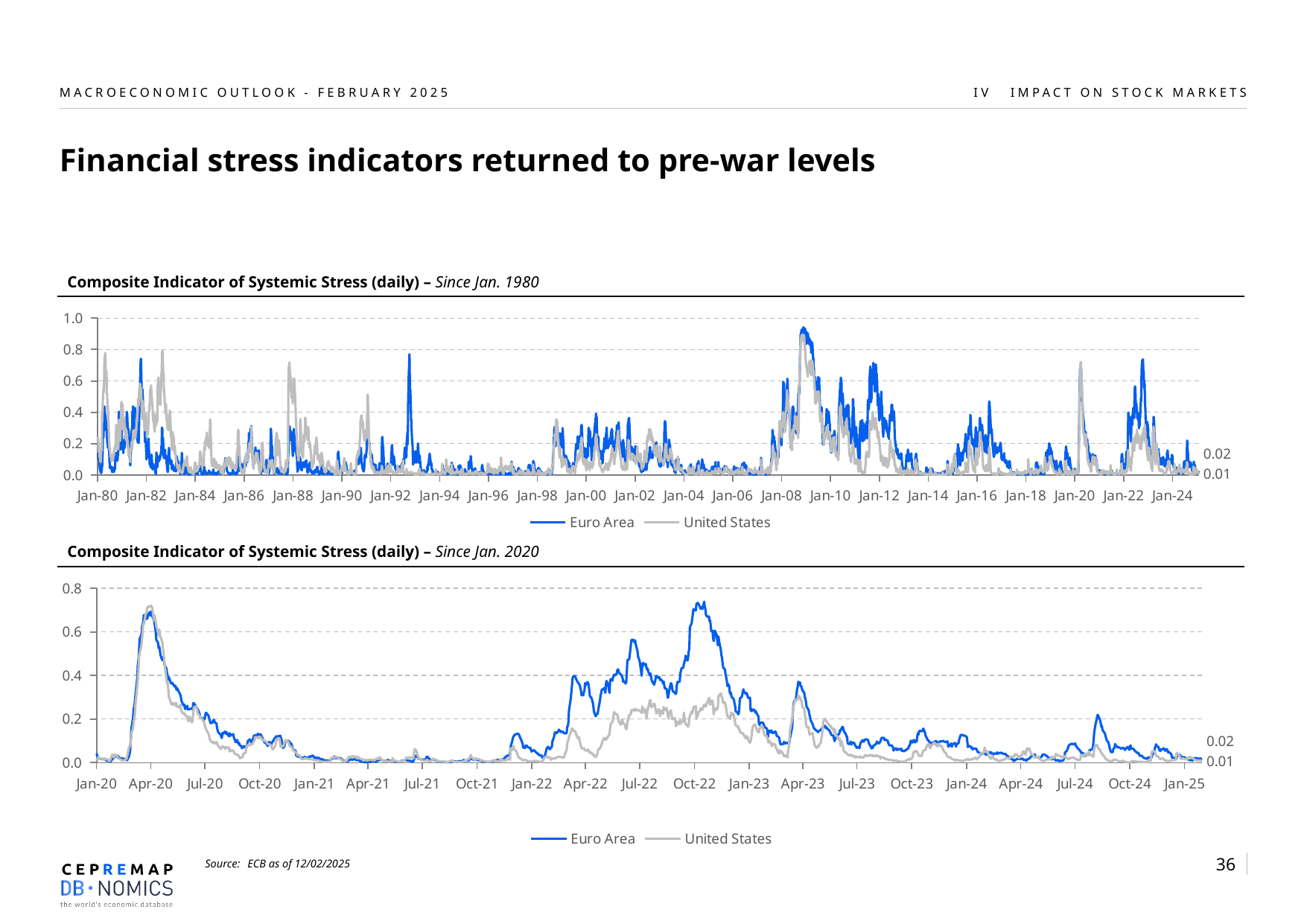
In the top chart, 'Since Jan. 1980', what is the latest value labelled for the United States series? 0.01 In the bottom chart, 'Since Jan. 2020', what is the latest value labelled for the Euro Area series? 0.02 What kind of chart is the top chart, 'Composite Indicator of Systemic Stress (daily) – Since Jan. 1980'? Line chart In the bottom chart, 'Since Jan. 2020', is the peak value of the United States series around Oct-22 greater or less than 0.4? less In the bottom chart, 'Since Jan. 2020', what is the latest value labelled for the United States series? 0.01 In the top chart, 'Since Jan. 1980', is the peak value of the Euro Area series around Jan-09 greater or less than 0.8? greater In the bottom chart, 'Since Jan. 2020', which series is higher around Oct-22, Euro Area or United States? Euro Area How many series does the legend of the bottom chart, 'Since Jan. 2020', list? 2 In the top chart, 'Since Jan. 1980', which colour represents the United States series? Grey In the bottom chart, 'Since Jan. 2020', do the values fall or rise from Oct-22 to Jan-25 for the Euro Area series? Fall In the bottom chart, 'Since Jan. 2020', is the peak value of the Euro Area series around Oct-22 greater or less than 0.6? greater What is the title of the bottom chart? Composite Indicator of Systemic Stress (daily) – Since Jan. 2020